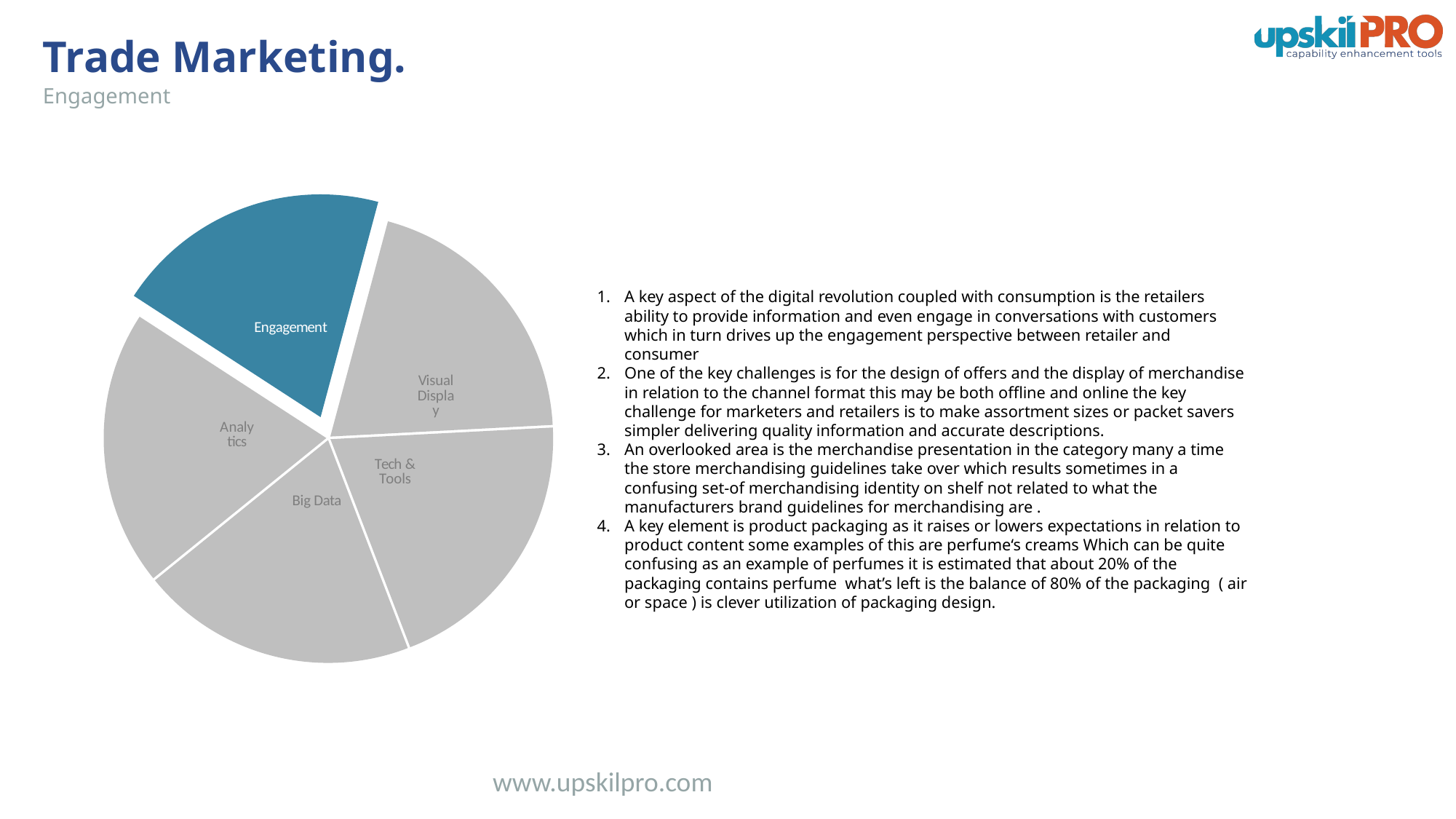
Name the five categories shown in the pie chart. Engagement, Visual Display, Tech & Tools, Big Data, Analytics Which slice of the pie chart is coloured blue? Engagement Which slice of the pie chart is pulled out (exploded) from the rest of the pie? Engagement Which slice of the pie chart is labelled 'Big Data'? Big Data How many slices does the pie chart have? 5 What kind of chart is shown on the slide? pie chart